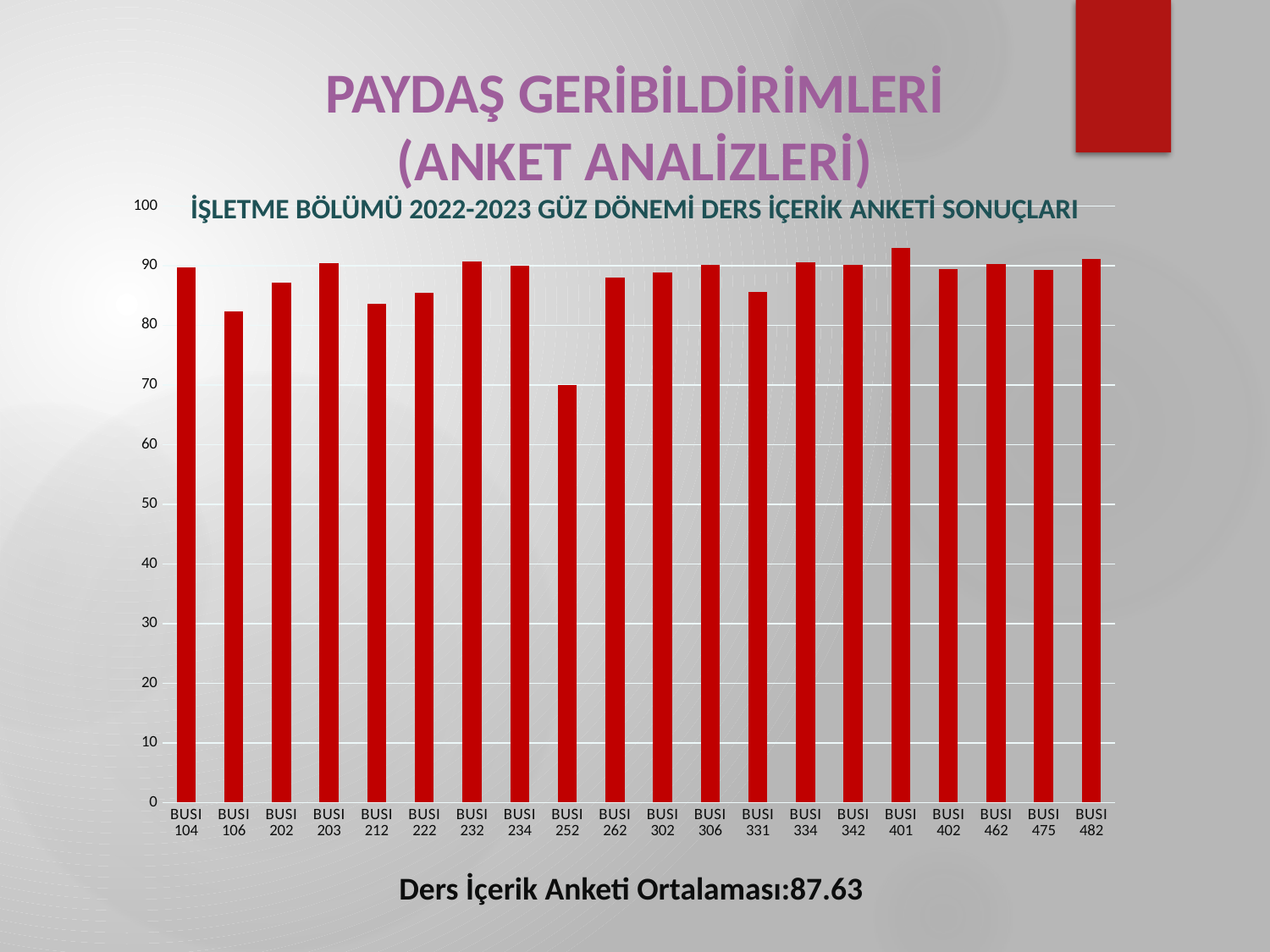
What is the title of the chart? İŞLETME BÖLÜMÜ 2022-2023 GÜZ DÖNEMİ DERS İÇERİK ANKETİ SONUÇLARI Is the value for BUSI 252 greater or less than 80? less Which course has the highest value in the chart? BUSI 401 Which is larger, the value for BUSI 104 or the value for BUSI 252? BUSI 104 Is the value for BUSI 106 greater or less than 80? greater Is the value for BUSI 401 greater or less than 90? greater How many courses (categories) are shown on the x axis of the chart? 20 Which is larger, the value for BUSI 106 or the value for BUSI 203? BUSI 203 What kind of chart is shown on the slide? bar chart Which course has the lowest value in the chart? BUSI 252 What colour are the bars in the chart? red